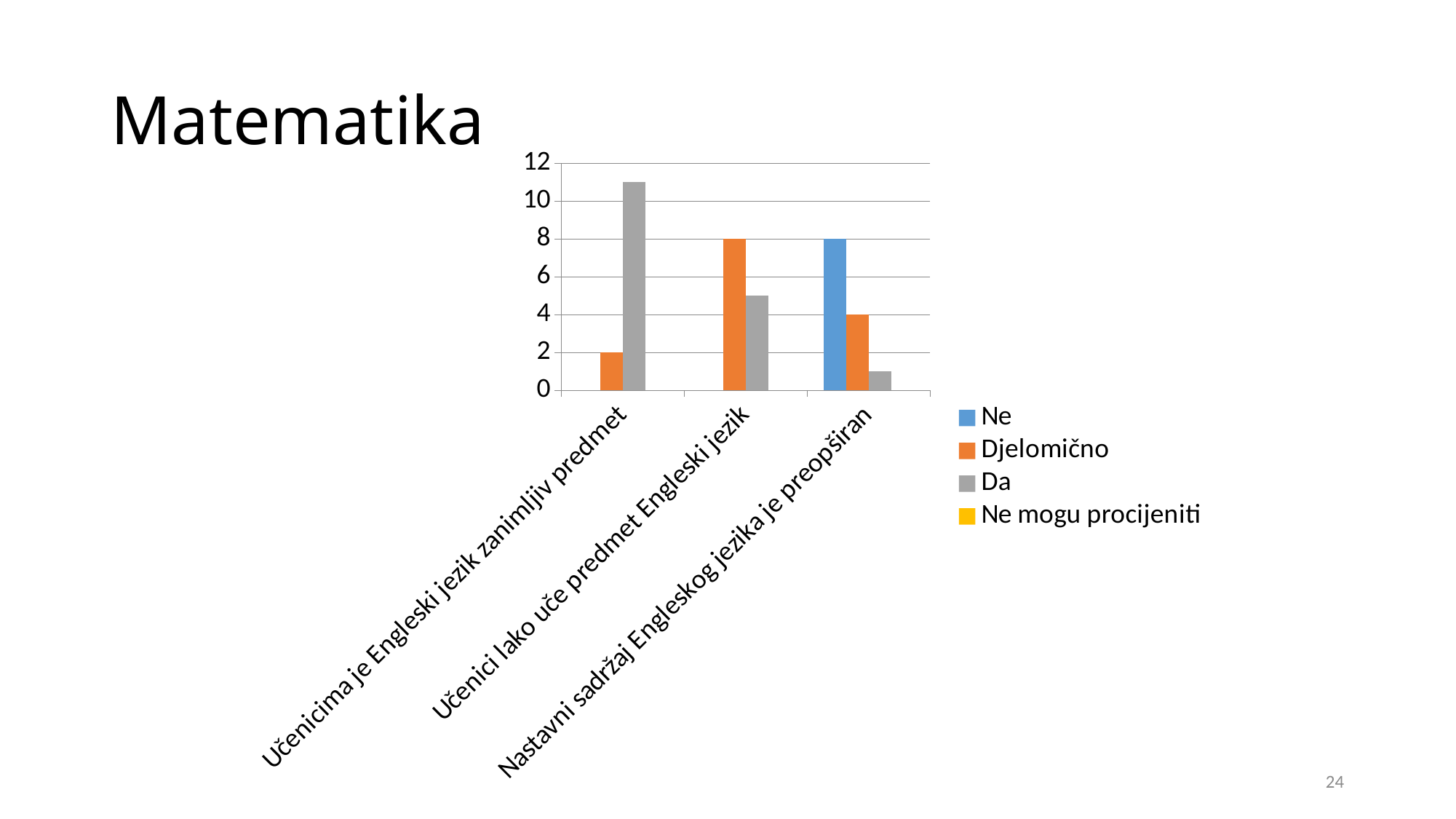
How many series does the legend list? 4 How many categories are shown on the x axis? 3 Is the value of Da for "Učenicima je Engleski jezik zanimljiv predmet" greater or less than 10? greater What is the value of Djelomično for "Učenicima je Engleski jezik zanimljiv predmet"? 2 For "Učenici lako uče predmet Engleski jezik", which is larger: Djelomično or Da? Djelomično What is the value of Djelomično for "Učenici lako uče predmet Engleski jezik"? 8 Is the value of Da for "Nastavni sadržaj Engleskog jezika je preopširan" greater or less than 2? less What is the difference between the Ne and Djelomično values for "Nastavni sadržaj Engleskog jezika je preopširan"? 4 Which series has the tallest bar in the whole chart? Da What is the value of Ne for "Nastavni sadržaj Engleskog jezika je preopširan"? 8 What kind of chart is shown on the slide? bar chart What is the value of Djelomično for "Nastavni sadržaj Engleskog jezika je preopširan"? 4